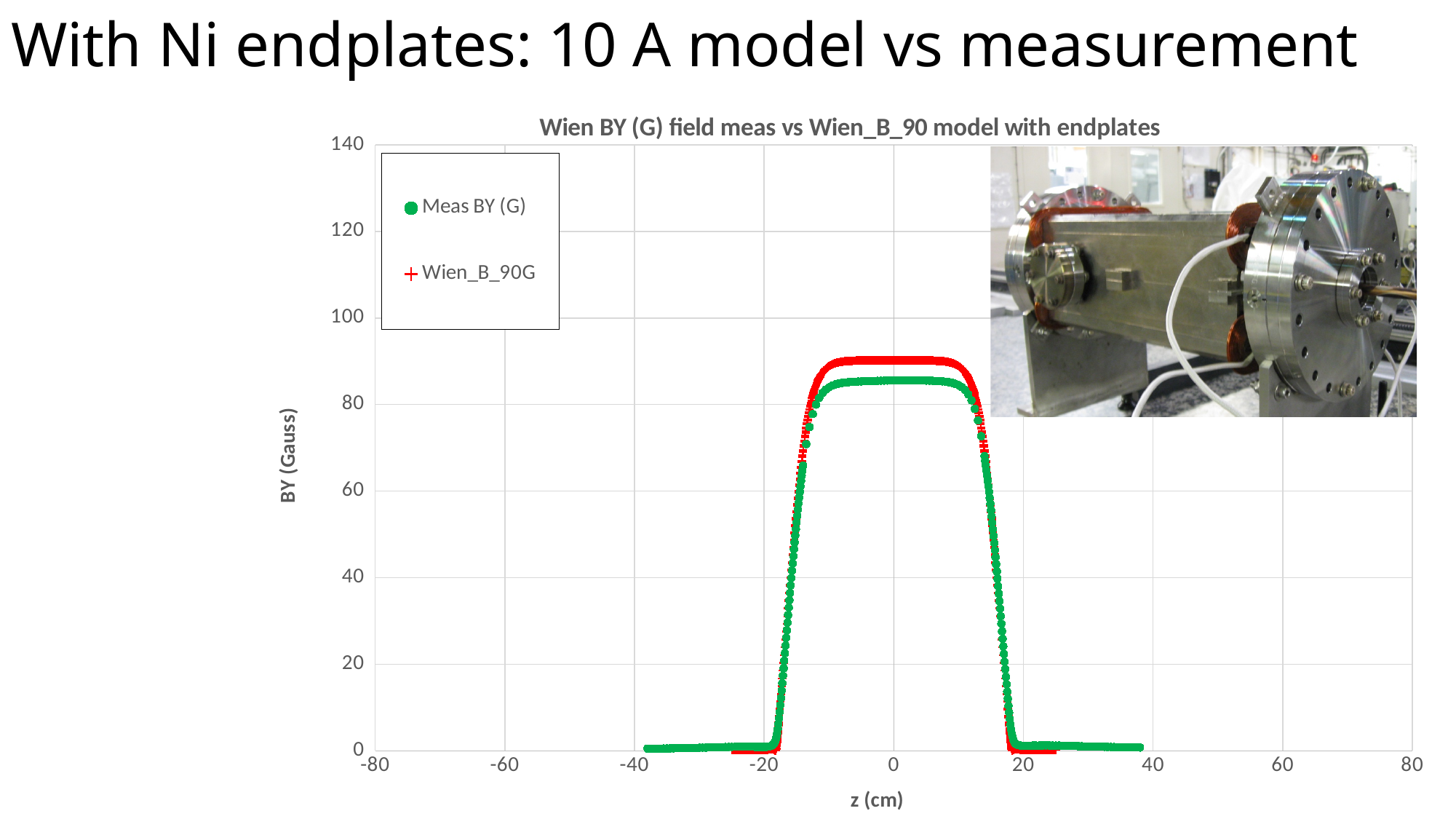
What kind of chart is shown on the slide? scatter chart Do the Meas BY (G) values rise or fall as z increases from 0 cm to 20 cm? fall How many series does the chart legend list? 2 At z = 0 cm, which series has the larger BY value, Meas BY (G) or Wien_B_90G? Wien_B_90G What is the label of the vertical axis of the chart? BY (Gauss) Is the Meas BY (G) value at z = 0 cm greater or less than 80 Gauss? greater What is the title of the chart? Wien BY (G) field meas vs Wien_B_90 model with endplates Is the Meas BY (G) value at z = 30 cm greater or less than 20 Gauss? less Do the Wien_B_90G values rise or fall as z increases from -20 cm to -10 cm? rise Is the Wien_B_90G value at z = 0 cm greater or less than 100 Gauss? less